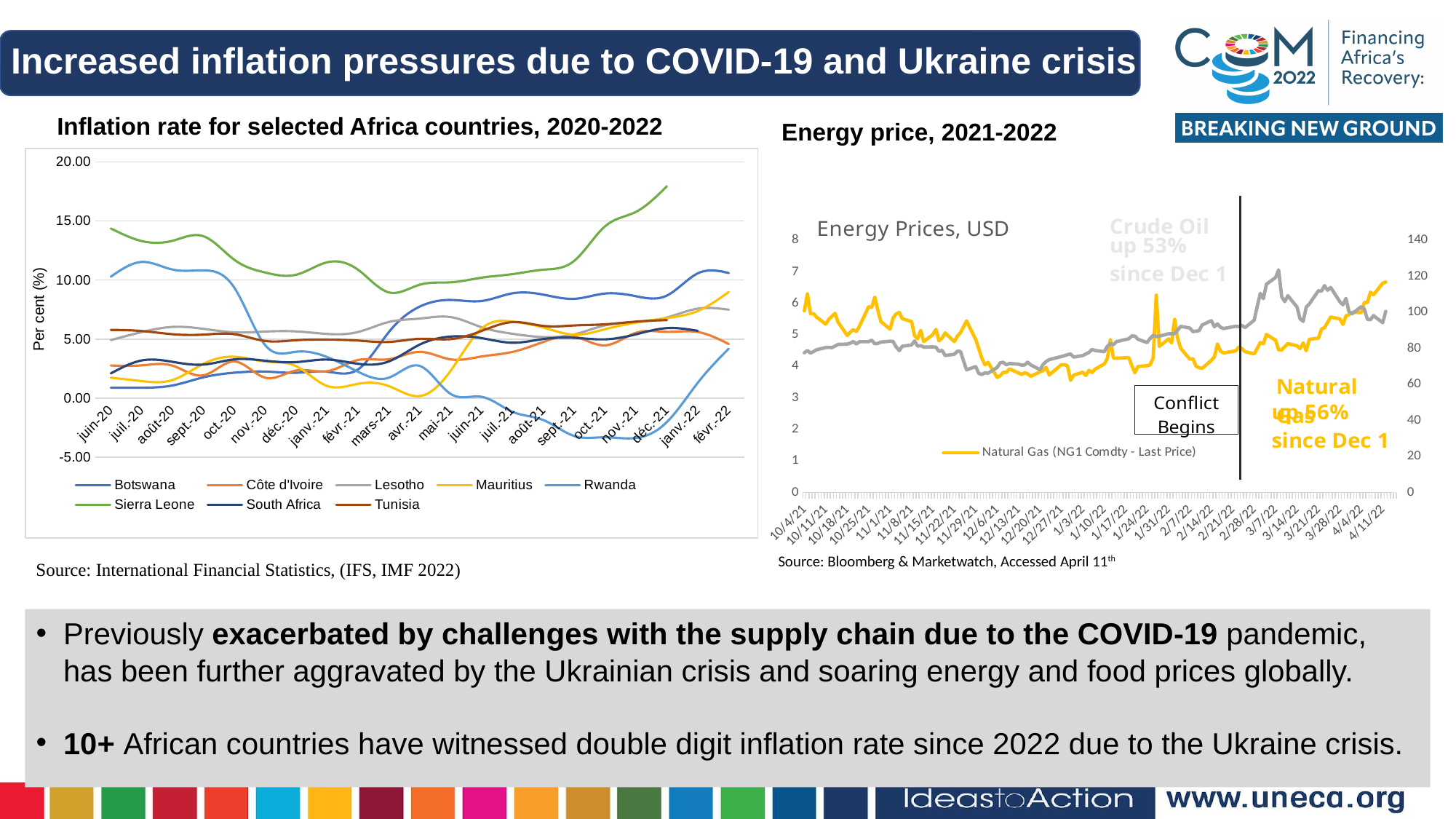
How many months are shown on the x axis of the 'Inflation rate for selected Africa countries, 2020-2022' chart? 21 In the 'Inflation rate for selected Africa countries, 2020-2022' chart, is the value for Rwanda in oct.-21 greater or less than 0.00? less How many series does the legend of the 'Inflation rate for selected Africa countries, 2020-2022' chart list? 8 In the 'Inflation rate for selected Africa countries, 2020-2022' chart, which country has the lowest inflation rate in oct.-21? Rwanda In the 'Energy price, 2021-2022' chart, how many series does the legend list? 1 According to the annotation on the 'Energy price, 2021-2022' chart, by how much has natural gas risen since Dec 1? 56% What type of chart is the 'Inflation rate for selected Africa countries, 2020-2022' chart? Line chart In the 'Inflation rate for selected Africa countries, 2020-2022' chart, which is larger in juin-20: Sierra Leone or Botswana? Sierra Leone What is the y-axis label of the 'Inflation rate for selected Africa countries, 2020-2022' chart? Per cent (%) In the 'Inflation rate for selected Africa countries, 2020-2022' chart, which country has the highest inflation rate in févr.-22? Botswana